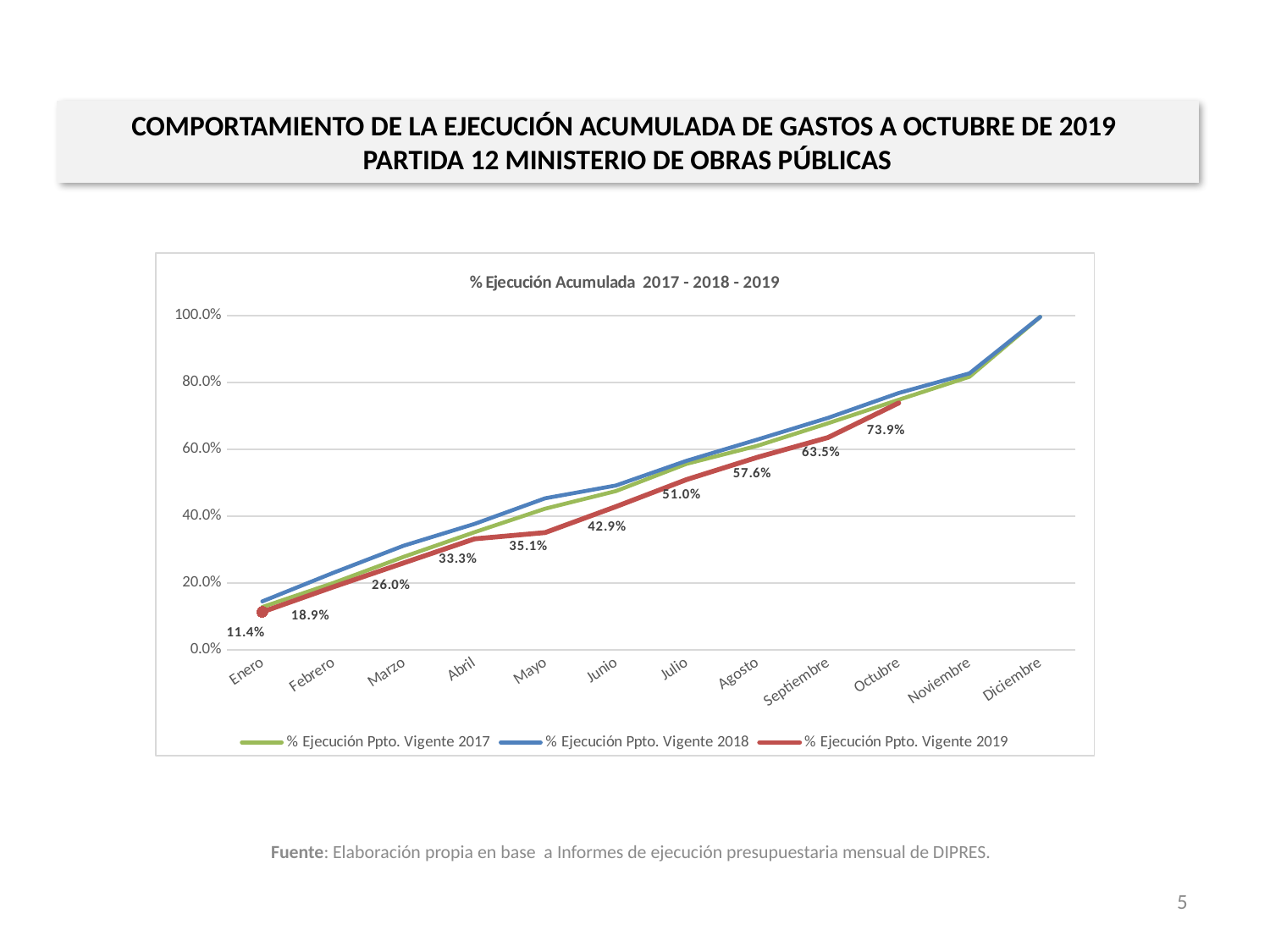
What is the value for % Ejecución Ppto. Vigente 2019 in Enero? 11.4% How many months are shown on the x axis? 12 What is the value for % Ejecución Ppto. Vigente 2019 in Octubre? 73.9% How many series does the legend list? 3 Is the value for % Ejecución Ppto. Vigente 2018 in Diciembre greater or less than 80.0%? greater What is the title of the chart? % Ejecución Acumulada 2017 - 2018 - 2019 What is the value for % Ejecución Ppto. Vigente 2019 in Junio? 42.9% Do the values for % Ejecución Ppto. Vigente 2019 rise or fall from Enero to Octubre? rise What is the difference between the 2019 values for Mayo and Abril? 1.8% What type of chart is shown on the slide? line chart What is the difference between the 2019 values for Octubre and Septiembre? 10.4% Which month has the highest labelled value for % Ejecución Ppto. Vigente 2019? Octubre